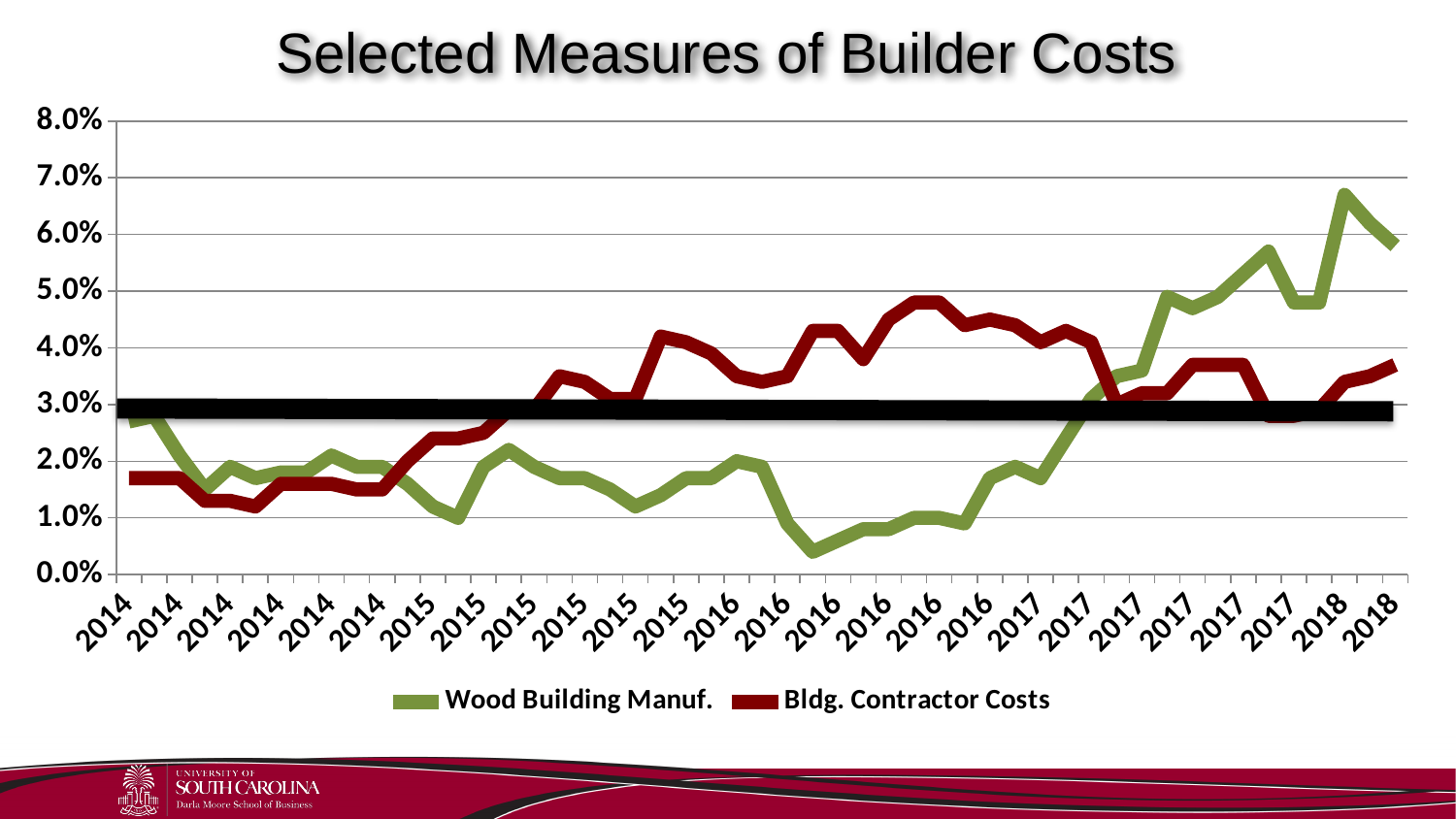
What is the title of the chart? Selected Measures of Builder Costs Which series reaches the highest value anywhere on the chart? Wood Building Manuf. Is the highest value reached by Wood Building Manuf. greater or less than 6.0%? greater Is the value for Wood Building Manuf. at the last 2018 point greater or less than 5.0%? greater Is the value for Bldg. Contractor Costs at the first 2014 point greater or less than 2.0%? less Which series is drawn in green? Wood Building Manuf. How many series does the legend list? 2 Which series reaches the lowest value anywhere on the chart? Wood Building Manuf. What kind of chart is shown on the slide? Line chart At the last 2018 point, which series has the higher value, Wood Building Manuf. or Bldg. Contractor Costs? Wood Building Manuf. Does the Wood Building Manuf. series rise or fall overall from the 2017 points to the 2018 points? rise